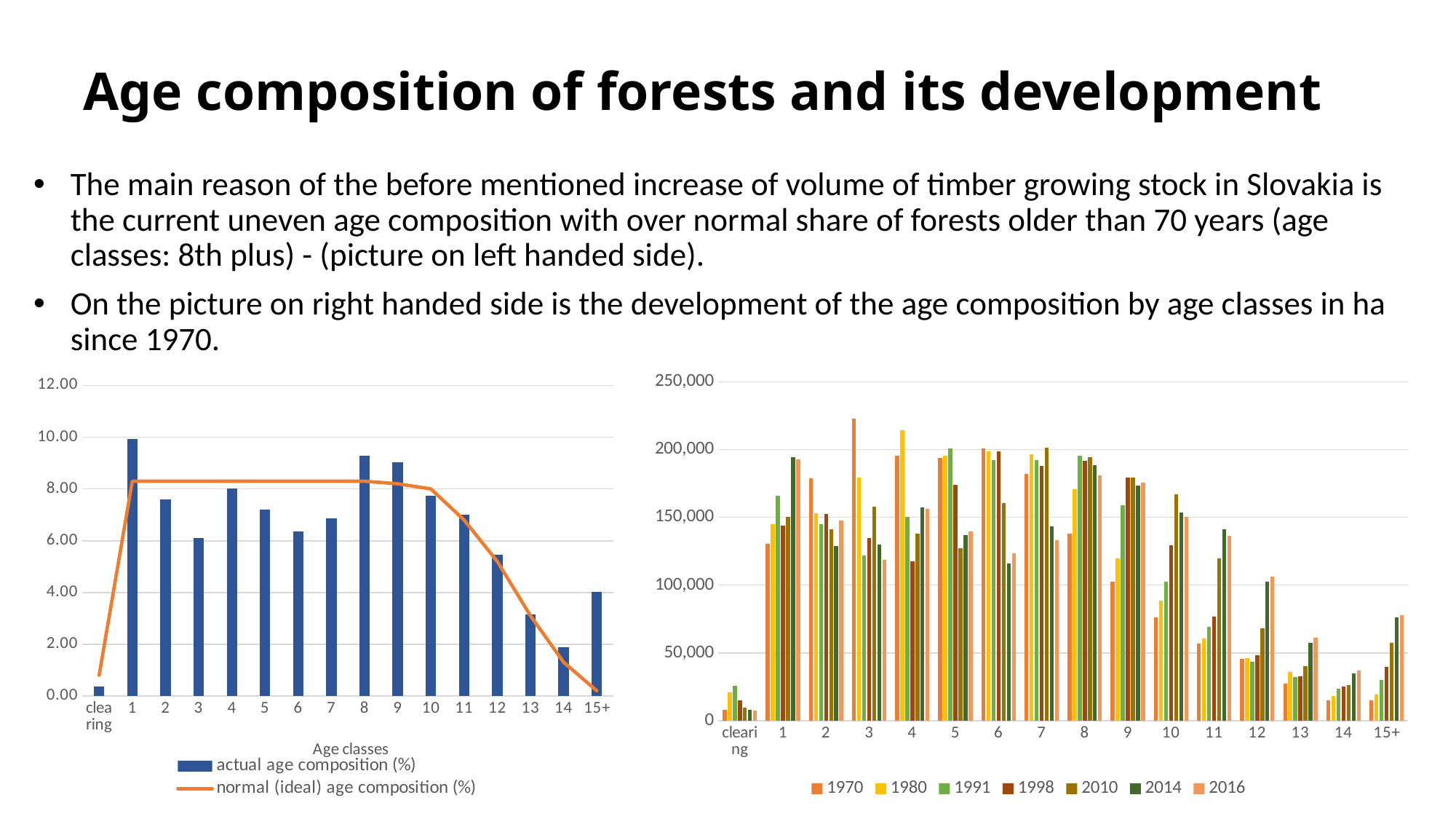
How many series does the legend of the right-hand chart list? 7 In the left-hand chart, which age class has the highest actual age composition bar? 1 In the left-hand chart, which category has the lowest actual age composition bar? clearing What does the orange line in the left-hand chart represent, according to its legend? normal (ideal) age composition (%) How many age-class categories are shown on the x axis of the left-hand chart? 16 In the right-hand chart, which is larger for age class 12, the 1970 value or the 2016 value? 2016 In the left-hand chart, do the actual age composition bars rise or fall from age class 10 to age class 14? fall In the right-hand chart, is the 1970 value for age class 3 greater or less than 200,000? greater In the left-hand chart, is the actual age composition for age class 13 greater or less than 4.00? less In the left-hand chart, is the actual age composition for age class 1 greater or less than 8.00? greater In the left-hand chart, which has the larger actual age composition bar, age class 2 or age class 3? age class 2 What kind of chart is the chart on the right side of the slide? bar chart